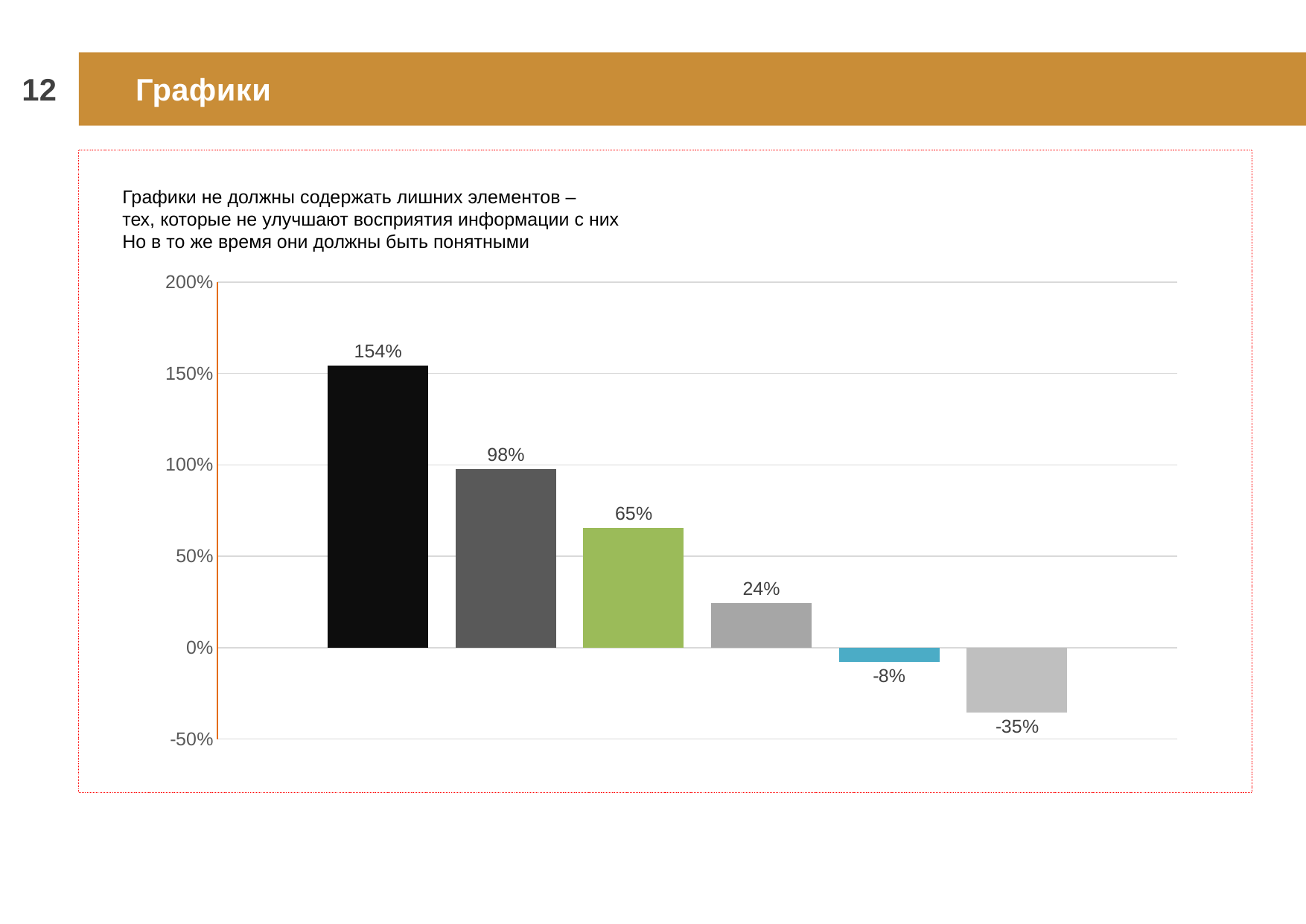
What is the value of the blue bar? -8% Which bar has the highest value? the first (black) bar, 154% What is the highest value shown on the vertical axis? 200% What is the value of the second bar from the left? 98% How many bars are plotted in the chart? 6 Do the bar values rise or fall from left to right? fall Which bar has the lowest value? the last (rightmost) bar, -35% What is the value of the green bar? 65% What is the value of the first (leftmost, black) bar? 154% What is the value of the last (rightmost) bar? -35% What type of chart is shown on the slide? bar chart What is the difference between the first bar (154%) and the second bar (98%)? 56%